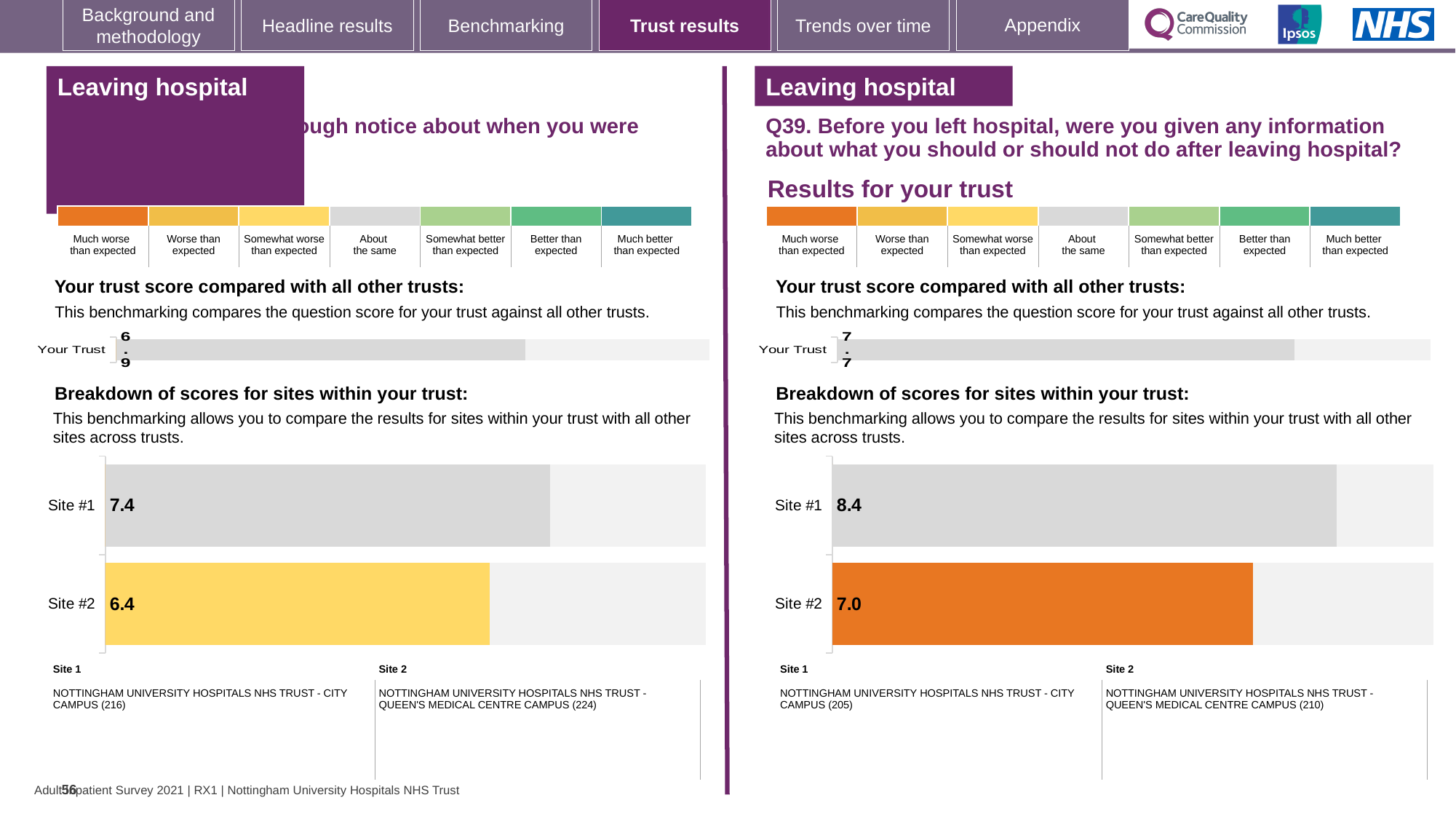
On the Q39 site breakdown chart, which site has the lower score? Site #2 On the Q39 site breakdown chart, what is the difference between the Site #1 and Site #2 scores? 1.4 On the left-hand site breakdown chart, what is the difference between the Site #1 and Site #2 scores? 1.0 On the left-hand 'Breakdown of scores for sites within your trust' chart, what is the score for Site #1? 7.4 On the Q39 'Your trust score compared with all other trusts' chart, what is the score shown for Your Trust? 7.7 On the Q39 'Breakdown of scores for sites within your trust' chart, what is the score for Site #1? 8.4 On the Q39 'Breakdown of scores for sites within your trust' chart, what is the score for Site #2? 7.0 On the left-hand 'Breakdown of scores for sites within your trust' chart, what is the score for Site #2? 6.4 How many sites are shown on the Q39 site breakdown chart? 2 On the left-hand site breakdown chart, which site has the higher score? Site #1 On the left-hand 'Your trust score compared with all other trusts' chart, what is the score shown for Your Trust? 6.9 What type of chart is used for the Q39 site breakdown? Bar chart